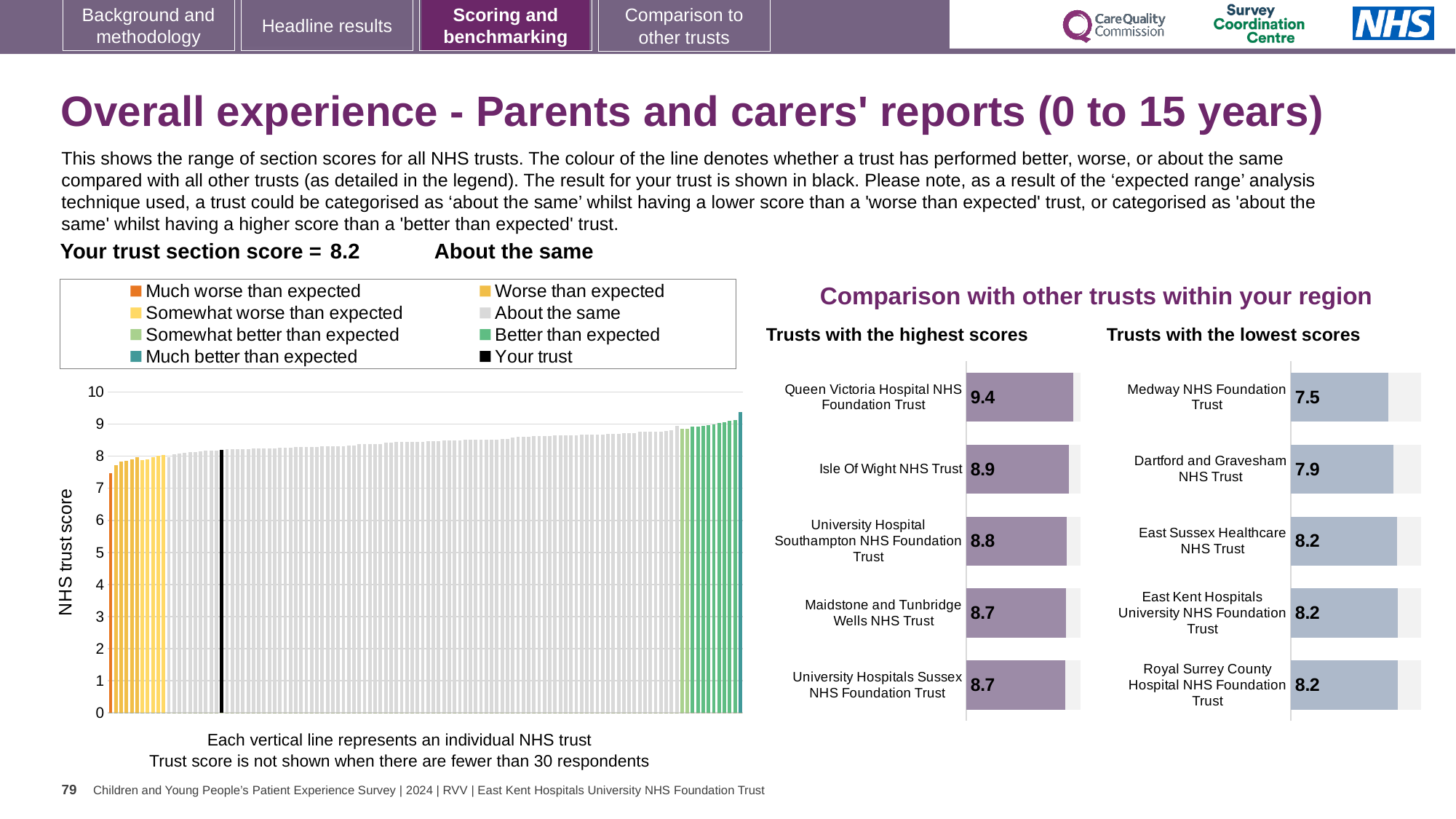
In the 'Trusts with the lowest scores' chart, what is the difference between the scores of Dartford and Gravesham NHS Trust and Medway NHS Foundation Trust? 0.4 How many trusts are shown in the 'Trusts with the lowest scores' chart? 5 In the large chart on the left showing all NHS trusts, do the trust scores rise or fall from left to right? rise In the 'Trusts with the highest scores' chart, what is the score for Isle Of Wight NHS Trust? 8.9 Which is larger: the score for University Hospital Southampton NHS Foundation Trust in the highest scores chart, or the score for East Sussex Healthcare NHS Trust in the lowest scores chart? University Hospital Southampton NHS Foundation Trust In the 'Trusts with the highest scores' chart, what is the difference between the scores of Queen Victoria Hospital NHS Foundation Trust and Isle Of Wight NHS Trust? 0.5 In the large chart on the left showing all NHS trusts, how many entries does the legend list? 8 In the 'Trusts with the highest scores' chart, which trust has the highest score? Queen Victoria Hospital NHS Foundation Trust In the 'Trusts with the lowest scores' chart, which trust has the lowest score? Medway NHS Foundation Trust In the 'Trusts with the lowest scores' chart, what is the score for Medway NHS Foundation Trust? 7.5 In the 'Trusts with the highest scores' chart, what is the score for Queen Victoria Hospital NHS Foundation Trust? 9.4 In the 'Trusts with the lowest scores' chart, what is the score for Dartford and Gravesham NHS Trust? 7.9